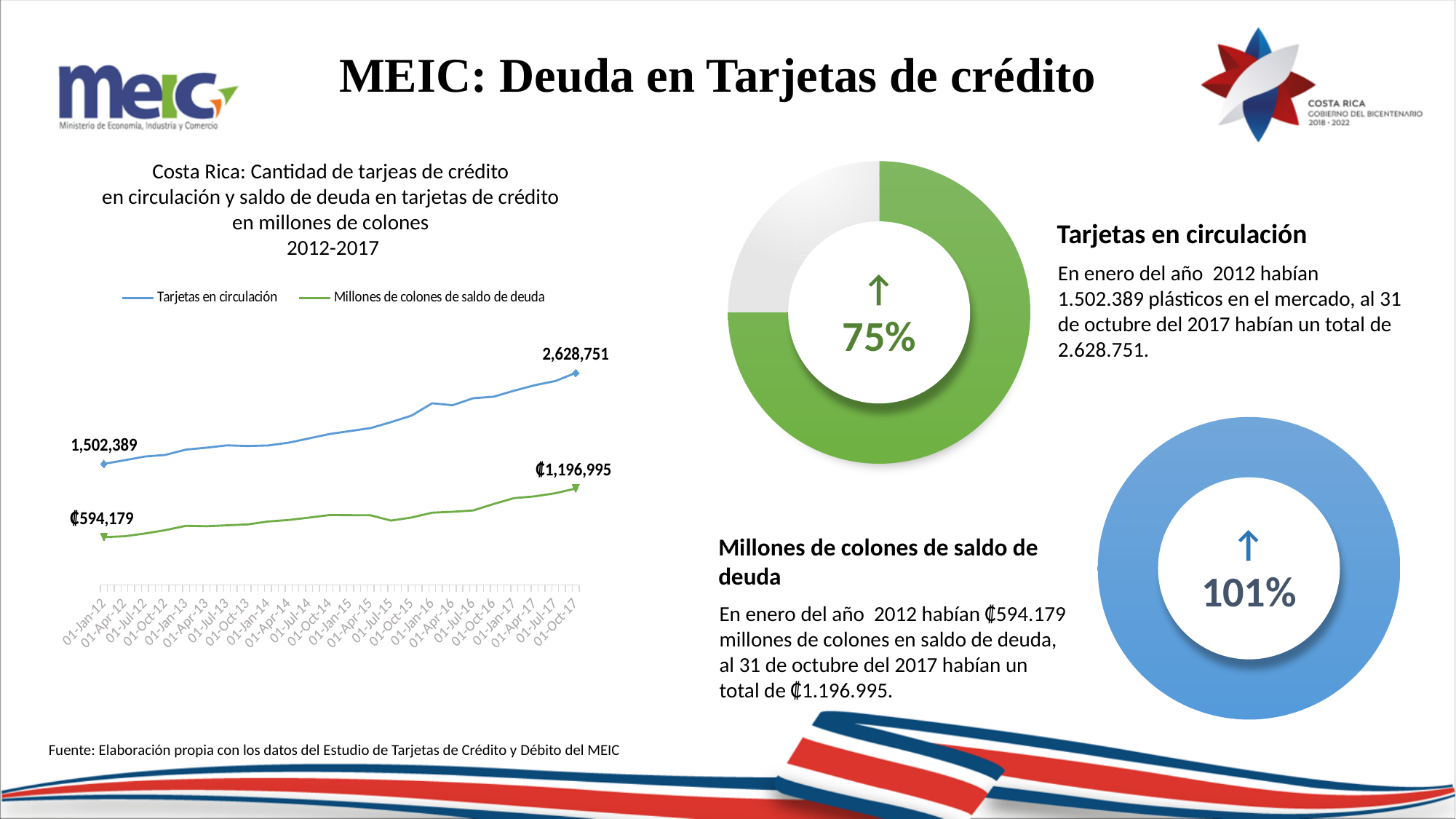
What percentage is shown in the green donut chart next to 'Tarjetas en circulación'? 75% In the line chart on the left, what is the value of 'Millones de colones de saldo de deuda' at 01-Jan-12? ₡594,179 In the line chart on the left, what is the value of 'Tarjetas en circulación' at 01-Oct-17? 2,628,751 In the line chart on the left, do the values of 'Tarjetas en circulación' rise or fall from 2012 to 2017? Rise How many series does the legend of the line chart on the left list? 2 In the line chart on the left, what is the value of 'Tarjetas en circulación' at 01-Jan-12? 1,502,389 In the line chart on the left, what is the difference between the 'Millones de colones de saldo de deuda' values at 01-Oct-17 and 01-Jan-12? ₡602,816 What kind of chart is the chart titled 'Costa Rica: Cantidad de tarjeas de crédito en circulación y saldo de deuda en tarjetas de crédito'? Line chart What percentage is shown in the blue donut chart next to 'Millones de colones de saldo de deuda'? 101% In the line chart on the left, what is the value of 'Millones de colones de saldo de deuda' at 01-Oct-17? ₡1,196,995 In the line chart on the left, which series has the higher value at 01-Oct-17, 'Tarjetas en circulación' or 'Millones de colones de saldo de deuda'? Tarjetas en circulación In the line chart on the left, by how much did 'Tarjetas en circulación' increase between 01-Jan-12 and 01-Oct-17? 1,126,362